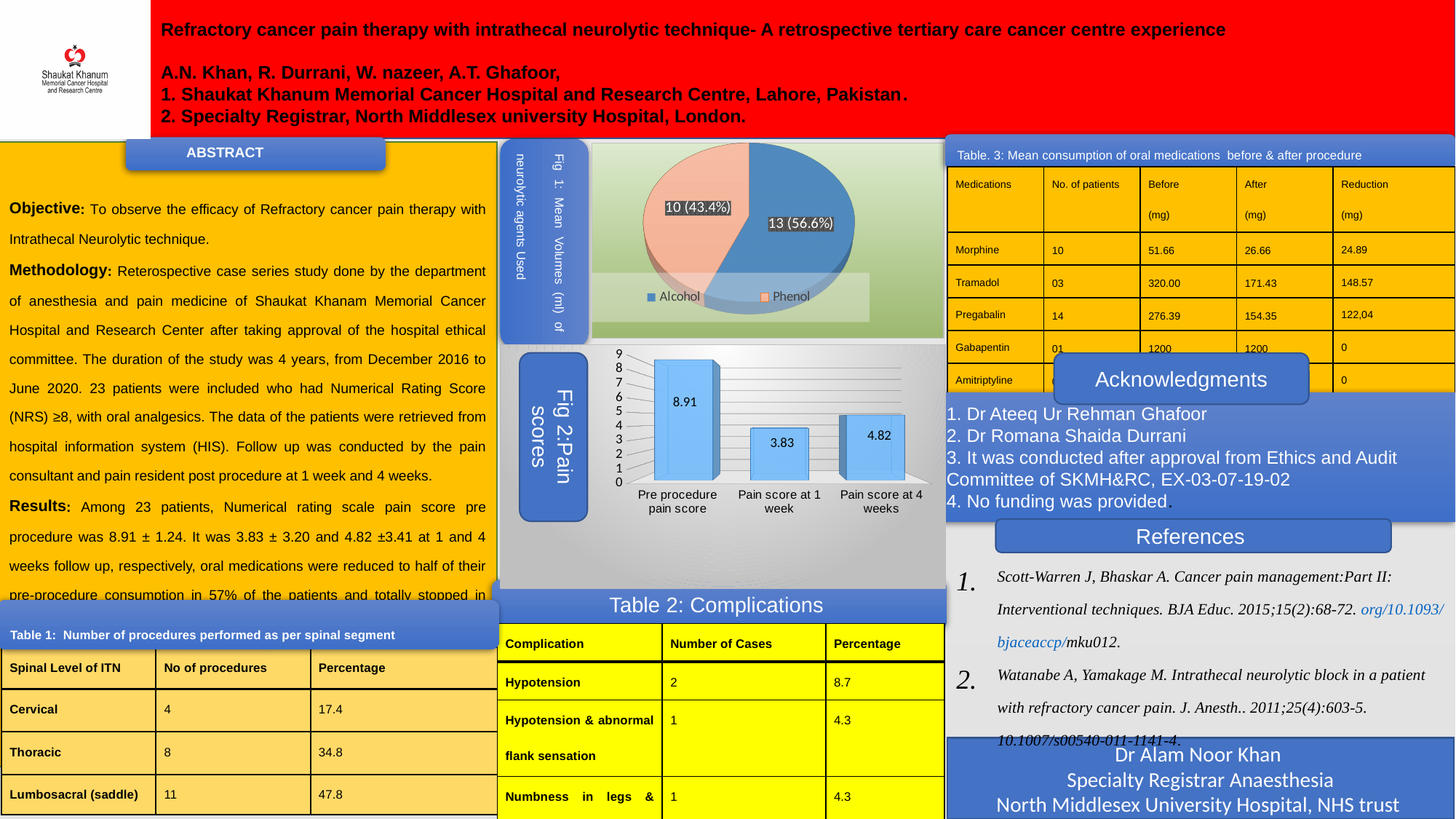
In the pie chart (Fig 1), what value is shown for Phenol? 10 (43.4%) How many entries does the legend of the pie chart (Fig 1) list? 2 In the bar chart (Fig 2: Pain scores), which category has the lowest value? Pain score at 1 week In the pie chart (Fig 1), which agent has the larger share? Alcohol What type of chart is Fig 2: Pain scores? Bar chart In the pie chart (Fig 1), what value is shown for Alcohol? 13 (56.6%) In the bar chart (Fig 2: Pain scores), how many categories are shown on the x axis? 3 In the bar chart (Fig 2: Pain scores), what is the pain score at 4 weeks? 4.82 In the pie chart (Fig 1), what percentage share does Phenol have? 43.4% In the bar chart (Fig 2: Pain scores), what is the pre procedure pain score? 8.91 In the bar chart (Fig 2: Pain scores), what is the difference between the pre procedure pain score and the pain score at 1 week? 5.08 In the bar chart (Fig 2: Pain scores), what is the pain score at 1 week? 3.83